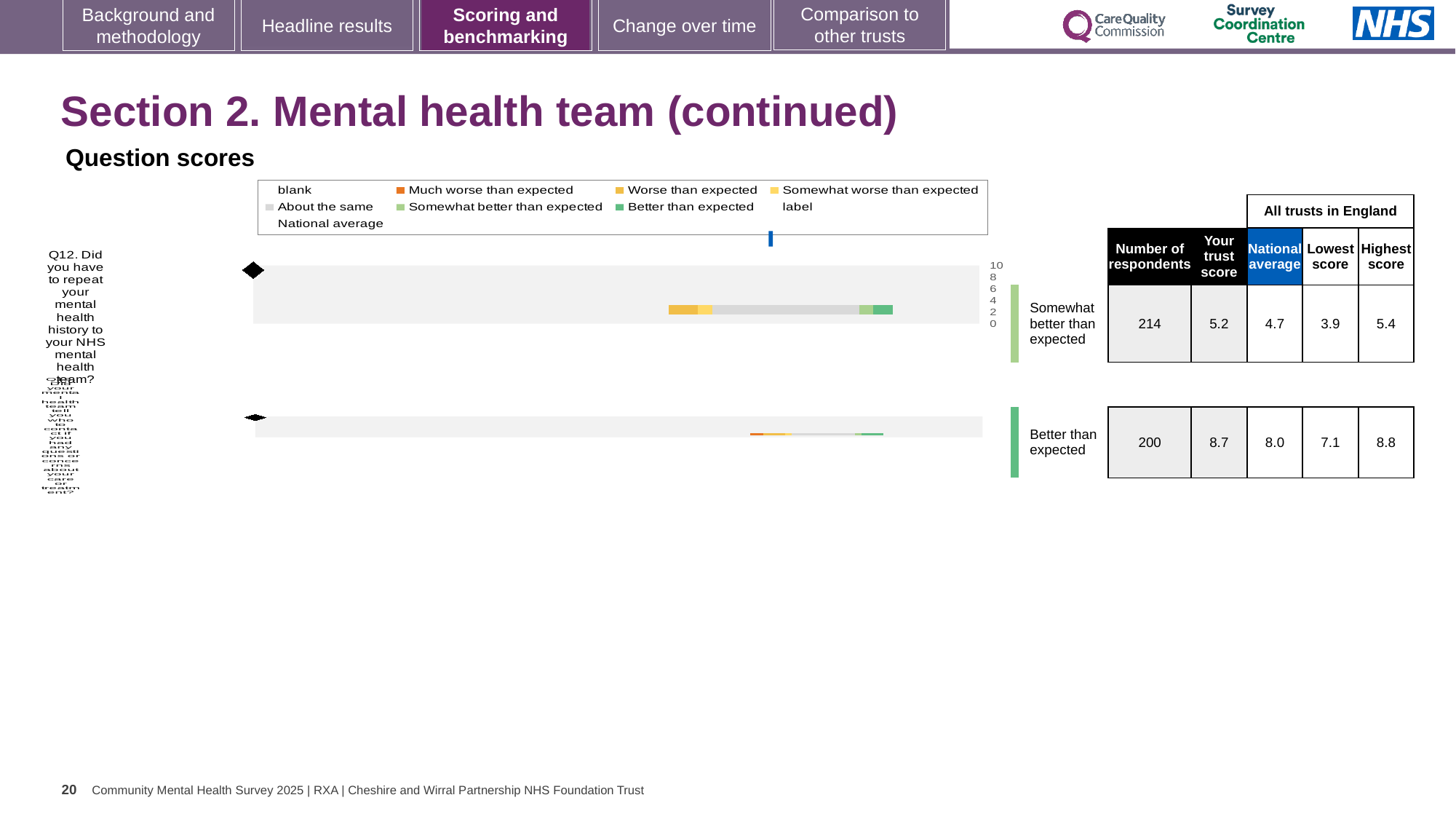
What benchmark category is shown for Q12 about repeating your mental health history? Somewhat better than expected What is the 'Your trust score' for Q12 (Did you have to repeat your mental health history to your NHS mental health team?)? 5.2 What is the difference between the highest and lowest scores for the second (bottom) question on the slide? 1.7 What is the highest score among all trusts in England for Q12 about repeating your mental health history? 5.4 What is the national average score for Q12 about repeating your mental health history? 4.7 How many respondents answered Q12 about repeating your mental health history? 214 How many questions are plotted in the question scores chart? 2 What kind of chart is used to show the question scores? Bar chart What is the lowest score among all trusts in England for Q12 about repeating your mental health history? 3.9 By how much does the trust score for Q12 exceed the national average? 0.5 For Q12, which is larger: the trust score or the national average? The trust score (5.2) What is the 'Your trust score' for the second (bottom) question on the slide? 8.7